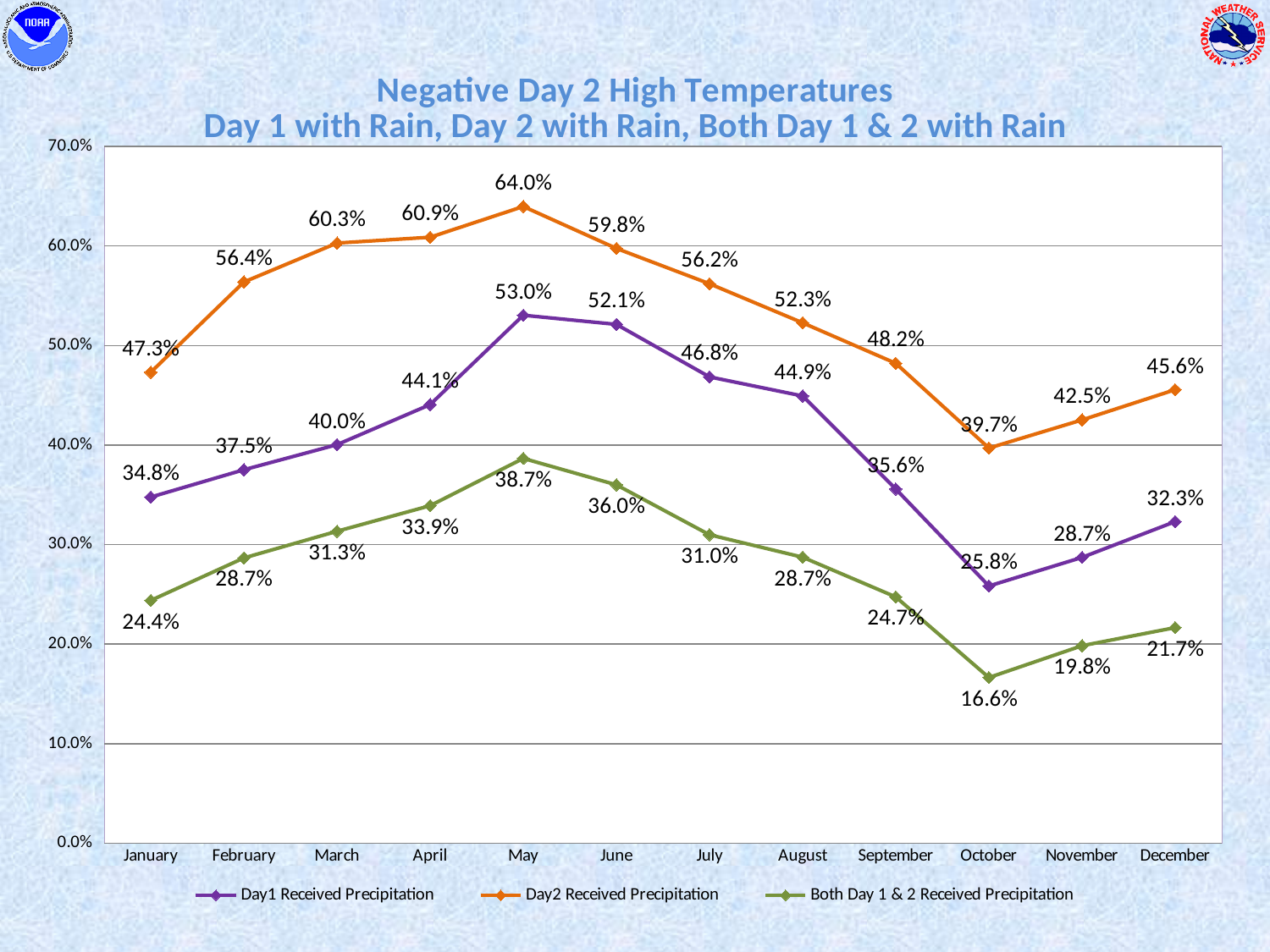
In which month is the Both Day 1 & 2 Received Precipitation series lowest? October How many months are plotted on the x axis? 12 What is the difference between the Day2 and Day1 Received Precipitation values in December? 13.3% What kind of chart is shown on the slide? Line chart Which is larger: the Day1 Received Precipitation value in June or in July? June Is the Day2 Received Precipitation value for October greater or less than 40.0%? less What is the Day1 Received Precipitation value for October? 25.8% In which month is the Day1 Received Precipitation series highest? May What is the Day2 Received Precipitation value for May? 64.0% How many series does the legend list? 3 Which series is drawn in orange? Day2 Received Precipitation What is the Both Day 1 & 2 Received Precipitation value for January? 24.4%